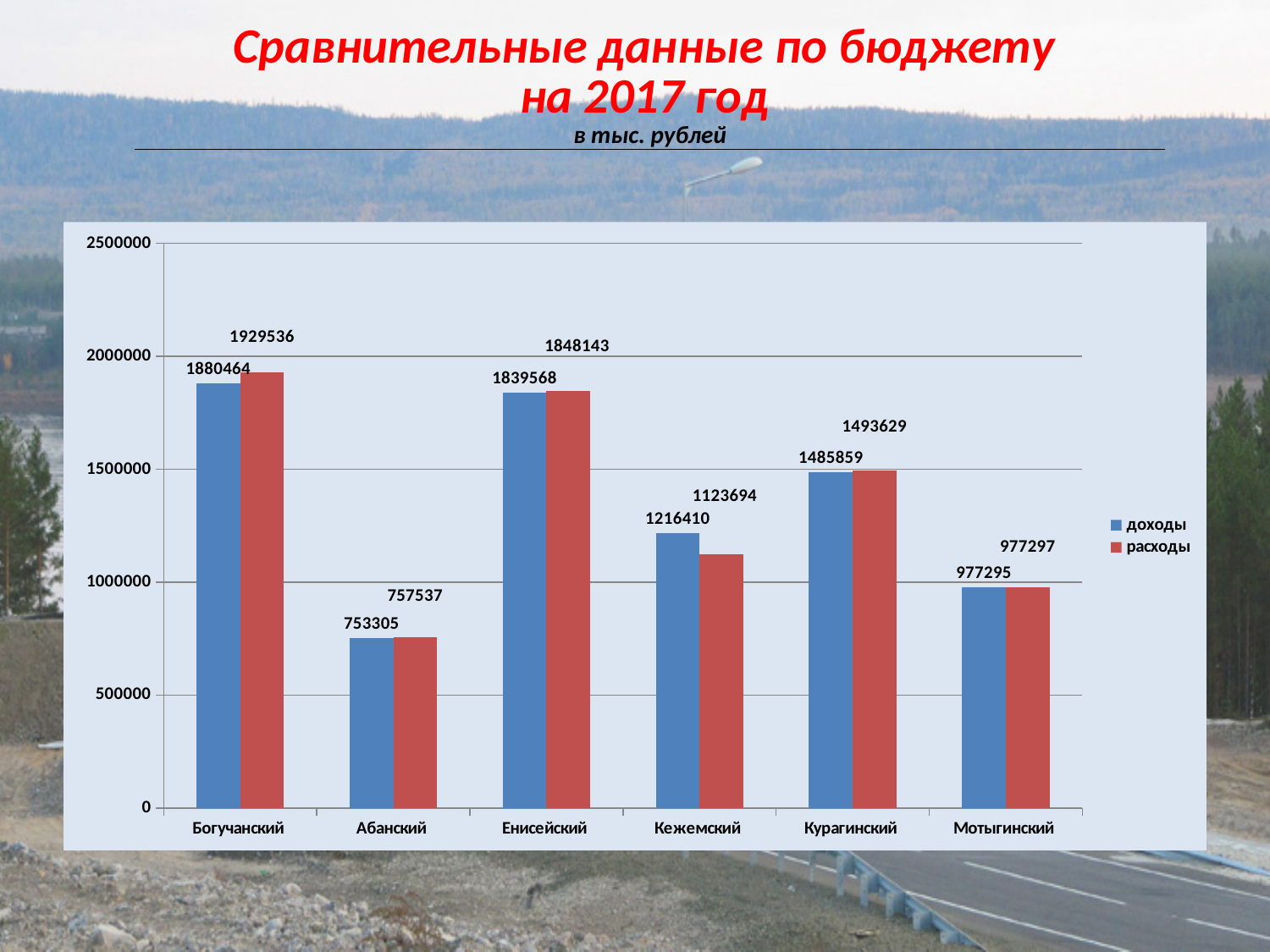
Which district has the lowest расходы? Абанский What type of chart is shown on the slide? bar chart How many series does the legend list? 2 For Кежемский, which is larger: доходы or расходы? доходы How many districts are shown on the x axis? 6 Is the value of доходы for Абанский greater or less than 1000000? less Which district has the highest доходы? Богучанский What is the value of доходы for Богучанский? 1880464 What is the value of расходы for Мотыгинский? 977297 What is the difference between доходы and расходы for Кежемский? 92716 What is the difference between расходы and доходы for Богучанский? 49072 What is the value of расходы for Кежемский? 1123694